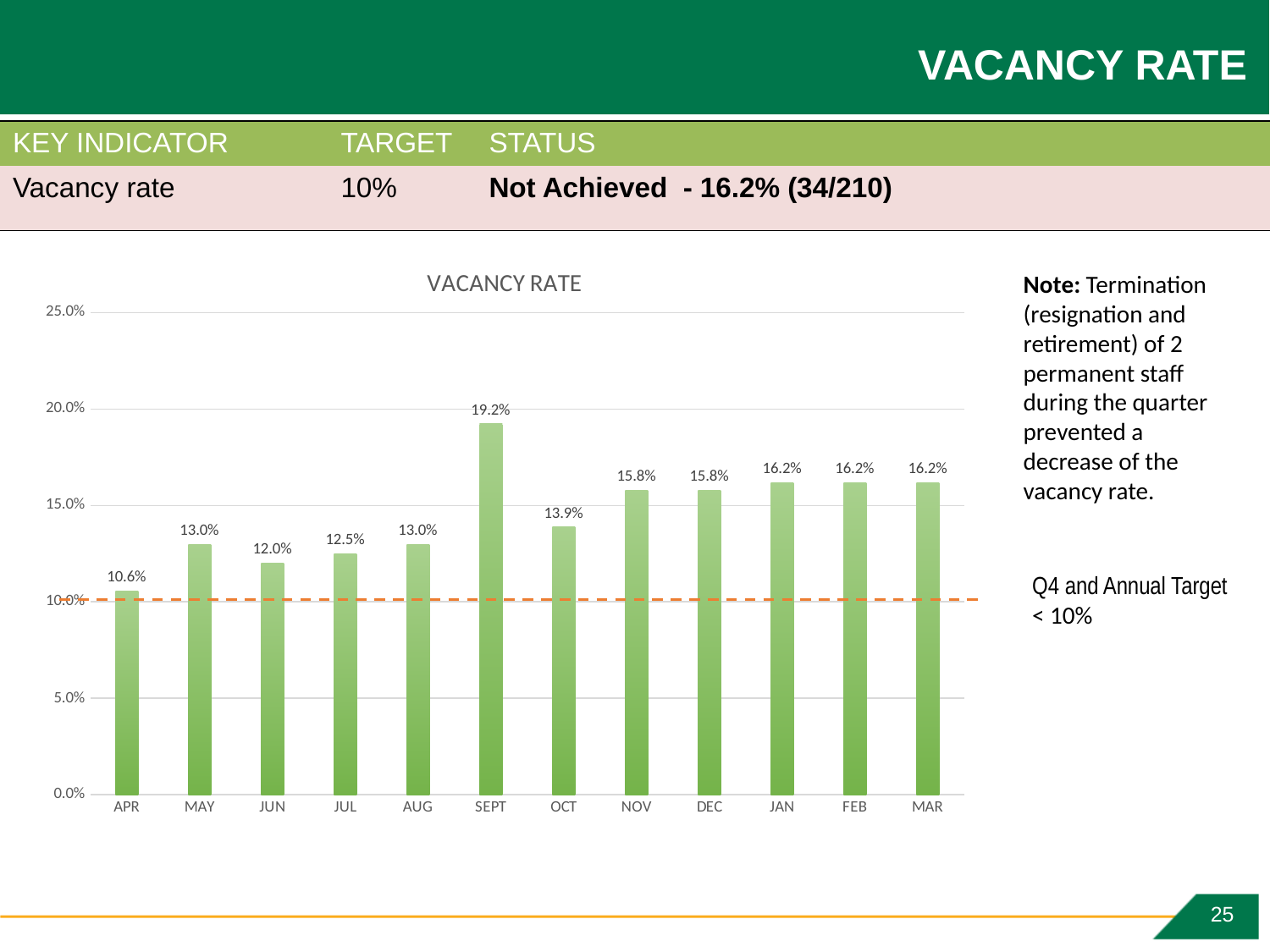
Which month has the lowest vacancy rate? APR Does the vacancy rate rise or fall from DEC to MAR? rise Is the vacancy rate for NOV greater or less than 15.0%? greater What is the vacancy rate for SEPT? 19.2% Which is larger, the vacancy rate for JUN or for JUL? JUL How many months are shown on the x axis of the chart? 12 What is the difference between the vacancy rate in SEPT and in OCT? 5.3% What kind of chart is shown on the slide? bar chart What is the vacancy rate for APR? 10.6% What is the title of the chart? VACANCY RATE Which month has the highest vacancy rate? SEPT What is the vacancy rate for OCT? 13.9%